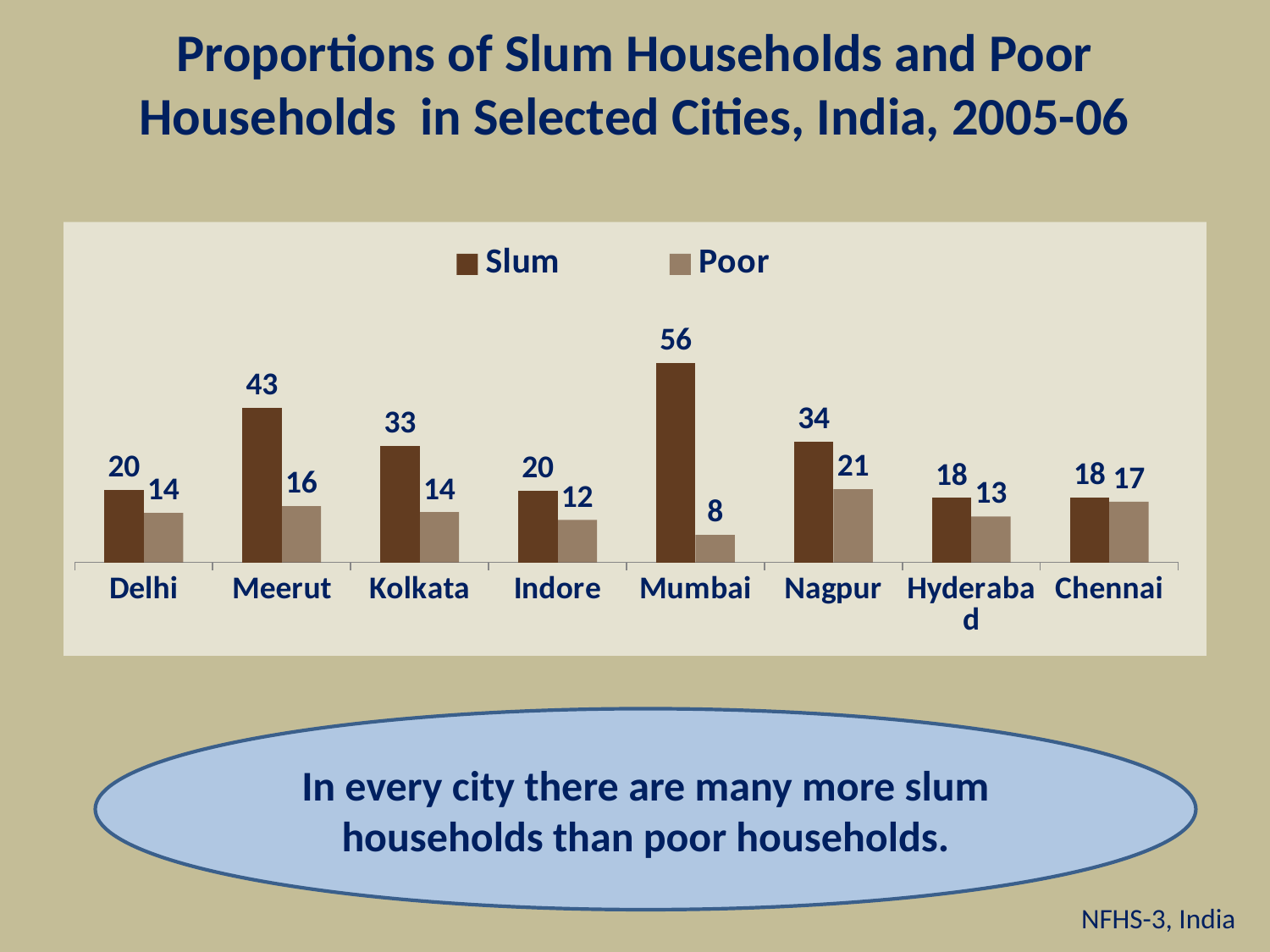
What are the two series named in the legend? Slum and Poor What is the Slum value for Mumbai? 56 Which city has the lowest Poor value? Mumbai Which city has the highest Slum value? Mumbai What is the difference between the Slum values for Meerut and Kolkata? 10 How many cities are shown on the x axis? 8 What is the difference between the Slum and Poor values for Mumbai? 48 What is the Poor value for Chennai? 17 What is the Poor value for Nagpur? 21 What kind of chart is shown on the slide? Bar chart How many series does the legend list? 2 Which is larger, the Slum value for Meerut or the Slum value for Nagpur? Meerut